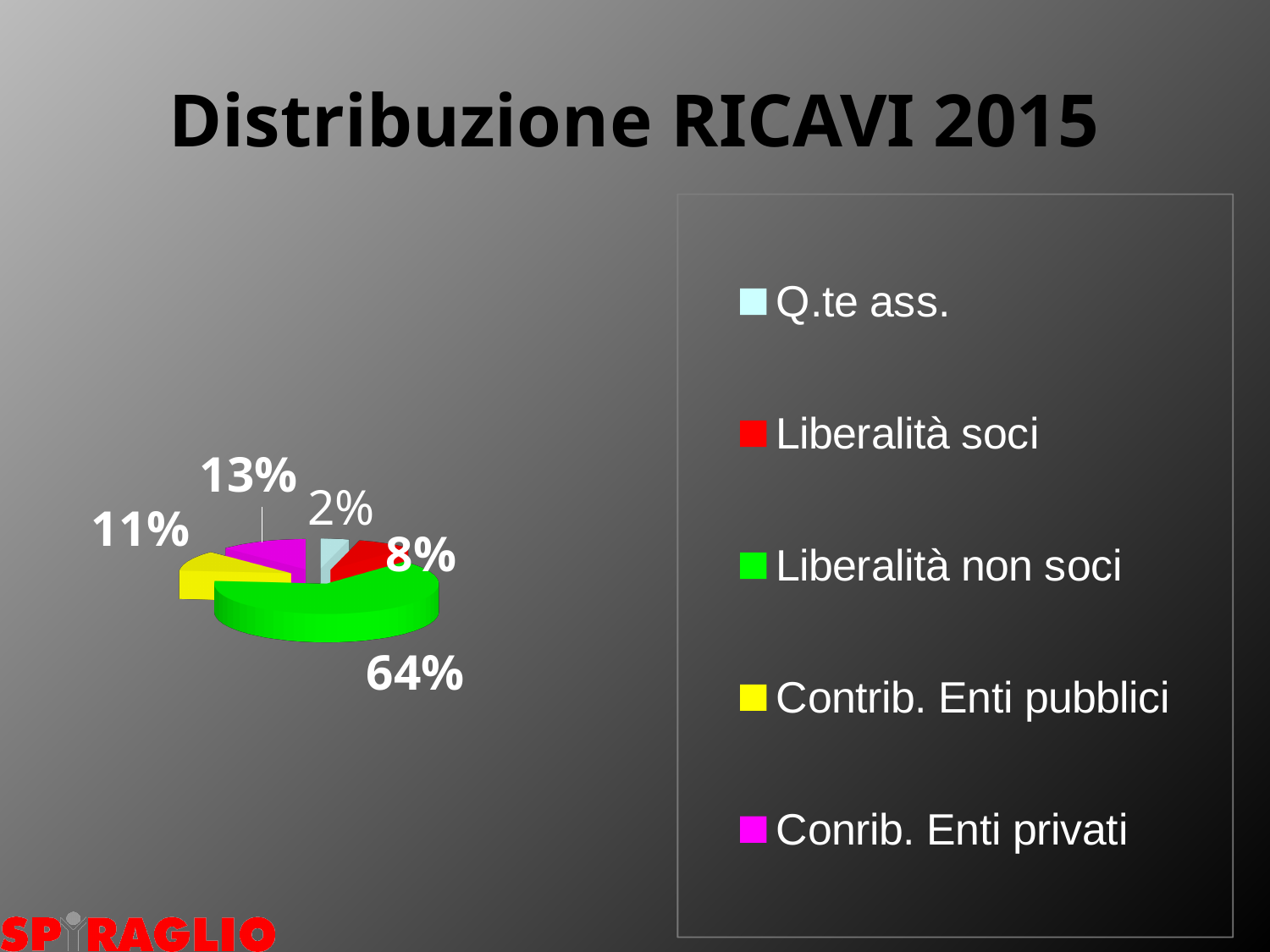
What is the title of the chart? Distribuzione RICAVI 2015 Which category has the largest share of the pie? Liberalità non soci Which category has the smallest share of the pie? Q.te ass. What share of the pie is Liberalità soci? 8% What share of the pie is Conrib. Enti privati? 13% What kind of chart is shown on the slide? pie chart What share of the pie is Q.te ass.? 2% What is the difference between the shares of Liberalità non soci and Conrib. Enti privati? 51% How many categories does the legend list? 5 Which is larger, the share of Contrib. Enti pubblici or the share of Liberalità soci? Contrib. Enti pubblici